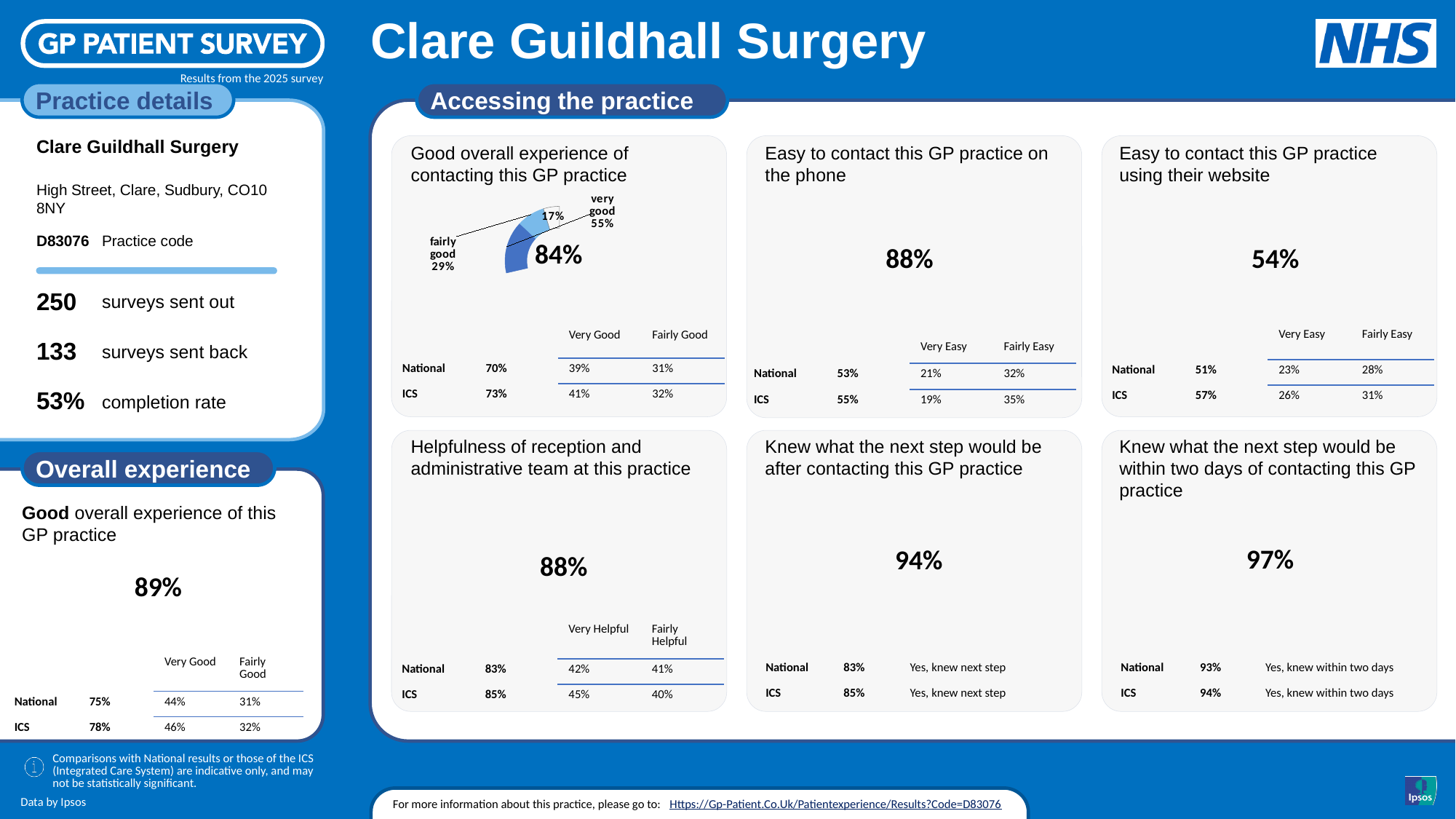
In the 'Good overall experience of contacting this GP practice' chart, what is the combined total of 'very good' and 'fairly good'? 84% In the 'Good overall experience of contacting this GP practice' chart, what is the difference in percentage points between 'very good' and 'fairly good'? 26 percentage points In the 'Good overall experience of contacting this GP practice' chart, which is larger: 'very good' or 'fairly good'? very good In the 'Good overall experience of contacting this GP practice' chart, what percentage is shown for 'fairly good'? 29% What value is printed in the centre of the 'Good overall experience of contacting this GP practice' chart? 84% What is the title of the panel containing the pie chart on the slide? Good overall experience of contacting this GP practice What kind of chart is used in the 'Good overall experience of contacting this GP practice' panel? Pie (doughnut) chart In the 'Good overall experience of contacting this GP practice' chart, what percentage is shown for 'very good'? 55% In the 'Good overall experience of contacting this GP practice' chart, which labelled slice is the largest? very good In the 'Good overall experience of contacting this GP practice' chart, is the 'very good' slice greater or less than 50%? greater